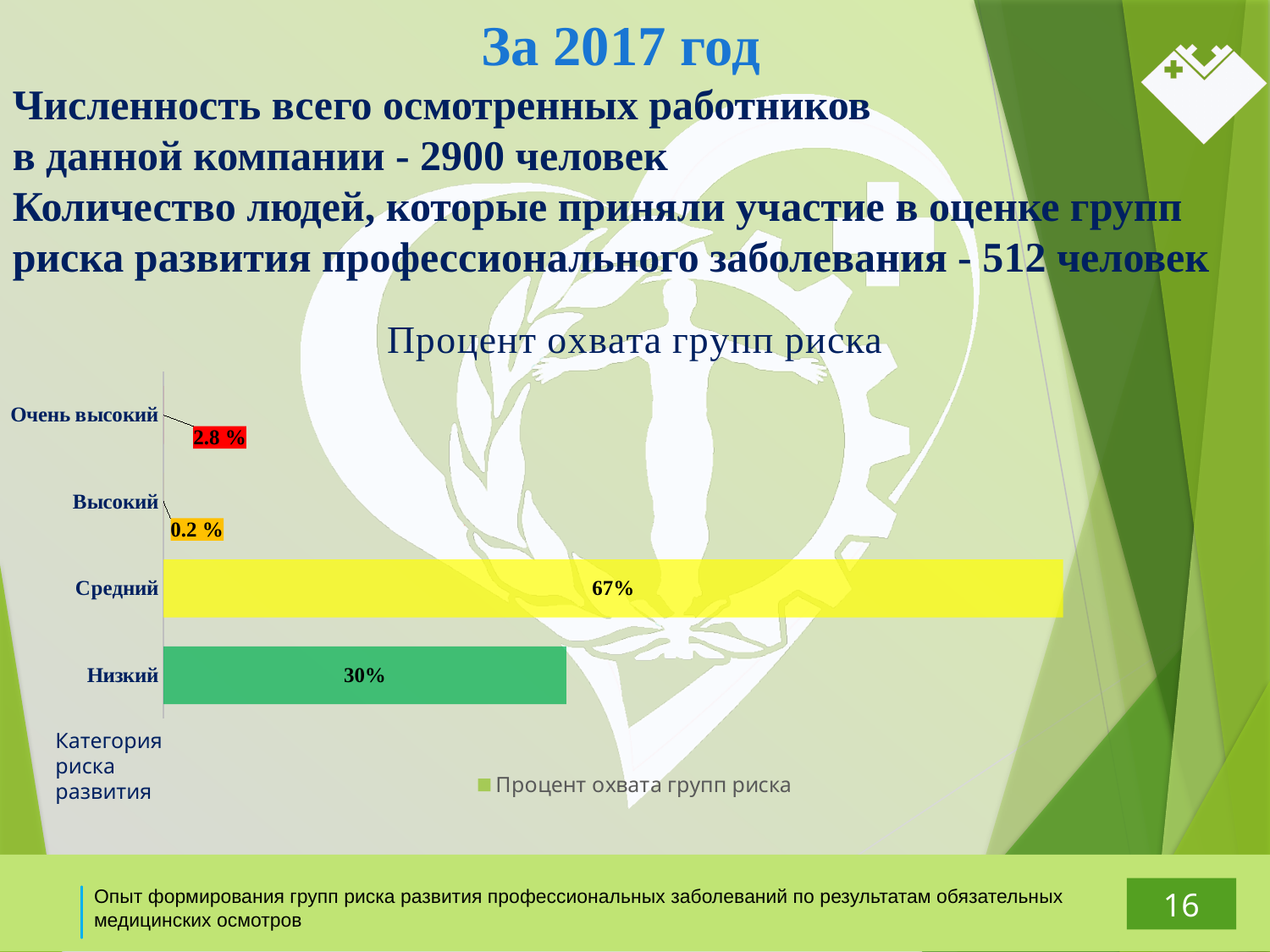
What is the title of the chart on the slide? Процент охвата групп риска What is the value for the "Низкий" category in the chart? 30% Which category has the lowest value in the chart? Высокий What kind of chart is shown on the slide? Bar chart Which category has the highest value in the chart? Средний How many categories are shown in the chart? 4 What is the value for the "Очень высокий" category in the chart? 2.8 % What is the value for the "Средний" category in the chart "Процент охвата групп риска"? 67% What is the difference between the values for "Средний" and "Низкий"? 37% What is the value for the "Высокий" category in the chart? 0.2 % Which is larger, the value for "Очень высокий" or the value for "Высокий"? Очень высокий How many series does the chart legend list? 1